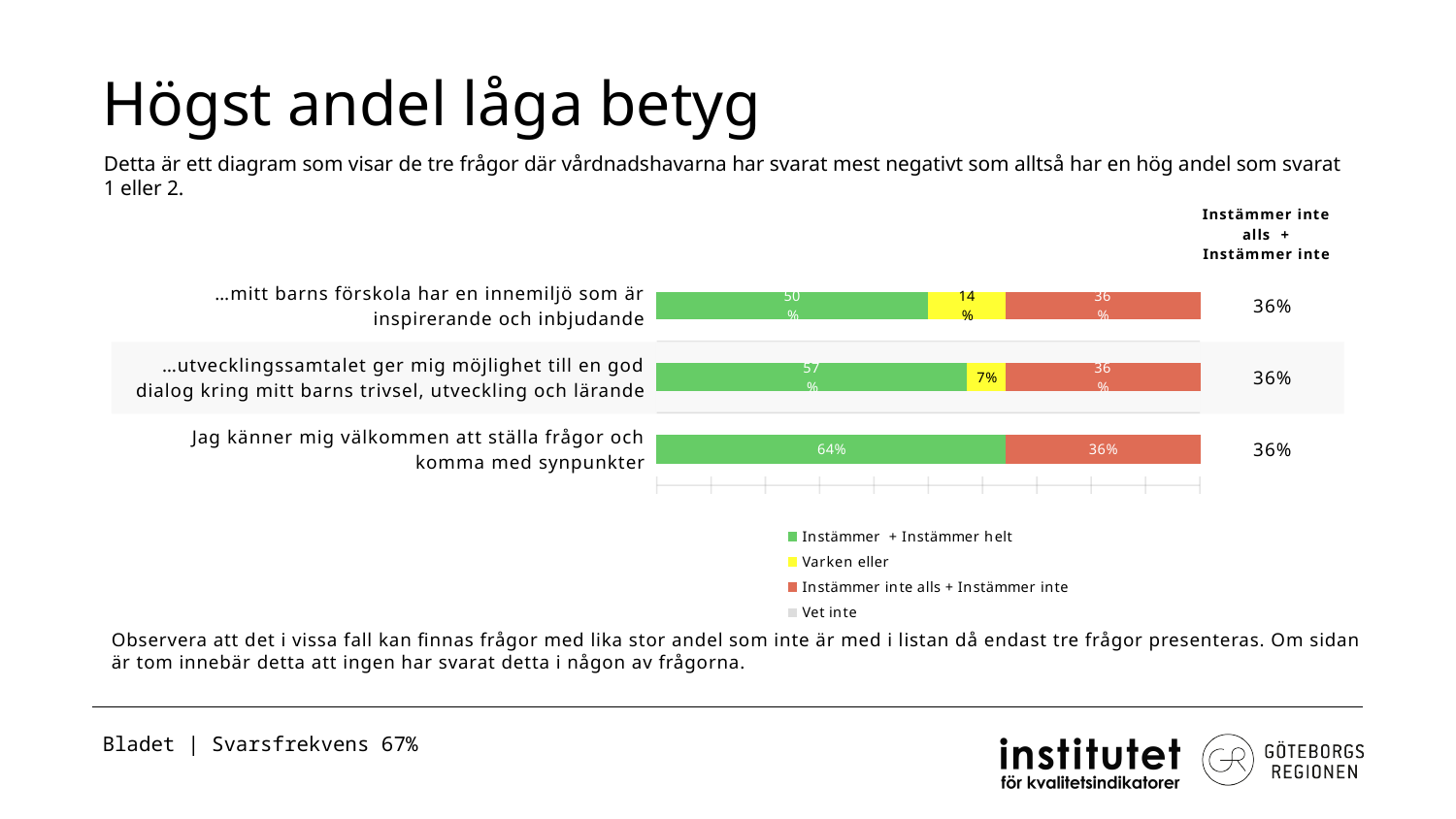
What is the value of 'Varken eller' for '…mitt barns förskola har en innemiljö som är inspirerande och inbjudande'? 14% What is the value of 'Instämmer + Instämmer helt' for '…utvecklingssamtalet ger mig möjlighet till en god dialog kring mitt barns trivsel, utveckling och lärande'? 57% Which is larger: the 'Varken eller' value for '…mitt barns förskola har en innemiljö som är inspirerande och inbjudande' or for '…utvecklingssamtalet ger mig möjlighet till en god dialog kring mitt barns trivsel, utveckling och lärande'? …mitt barns förskola har en innemiljö som är inspirerande och inbjudande What is the value of 'Instämmer + Instämmer helt' for 'Jag känner mig välkommen att ställa frågor och komma med synpunkter'? 64% What kind of chart is shown on the slide? Stacked bar chart What is the difference between the 'Instämmer + Instämmer helt' values for 'Jag känner mig välkommen att ställa frågor och komma med synpunkter' and '…mitt barns förskola har en innemiljö som är inspirerande och inbjudande'? 14% What is the value of 'Varken eller' for '…utvecklingssamtalet ger mig möjlighet till en god dialog kring mitt barns trivsel, utveckling och lärande'? 7% How many series does the legend list? 4 Which question has the highest share of 'Instämmer + Instämmer helt'? Jag känner mig välkommen att ställa frågor och komma med synpunkter Which question has the lowest share of 'Instämmer + Instämmer helt'? …mitt barns förskola har en innemiljö som är inspirerande och inbjudande How many questions (categories) are plotted in the chart? 3 What value is shown in the 'Instämmer inte alls + Instämmer inte' column for 'Jag känner mig välkommen att ställa frågor och komma med synpunkter'? 36%